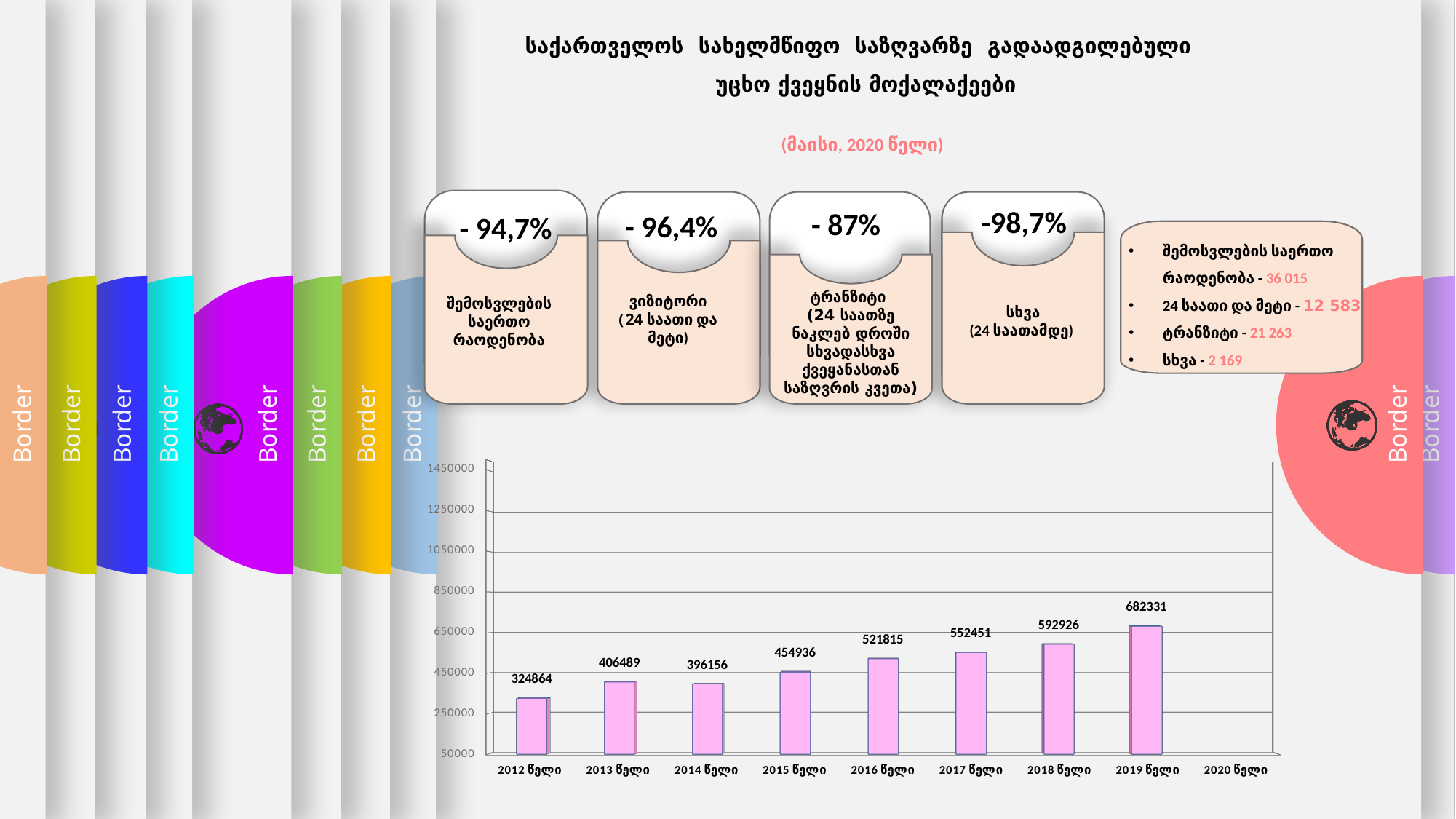
What is the value shown for 2012 წელი in the bar chart? 324864 What kind of chart is shown at the bottom of the slide? bar chart What is the value shown for 2019 წელი in the bar chart? 682331 Among the years with a plotted bar, which year has the lowest value? 2012 წელი Do the values in the bar chart generally rise or fall from 2012 to 2019? rise Is the value for 2019 წელი greater or less than 650000? greater How many year labels are shown on the x axis of the bar chart? 9 What is the value shown for 2016 წელი in the bar chart? 521815 Which year has the highest value in the bar chart? 2019 წელი What is the difference between the values for 2019 წელი and 2018 წელი? 89405 What is the difference between the values for 2013 წელი and 2014 წელი? 10333 Which is larger, the value for 2013 წელი or the value for 2014 წელი? 2013 წელი